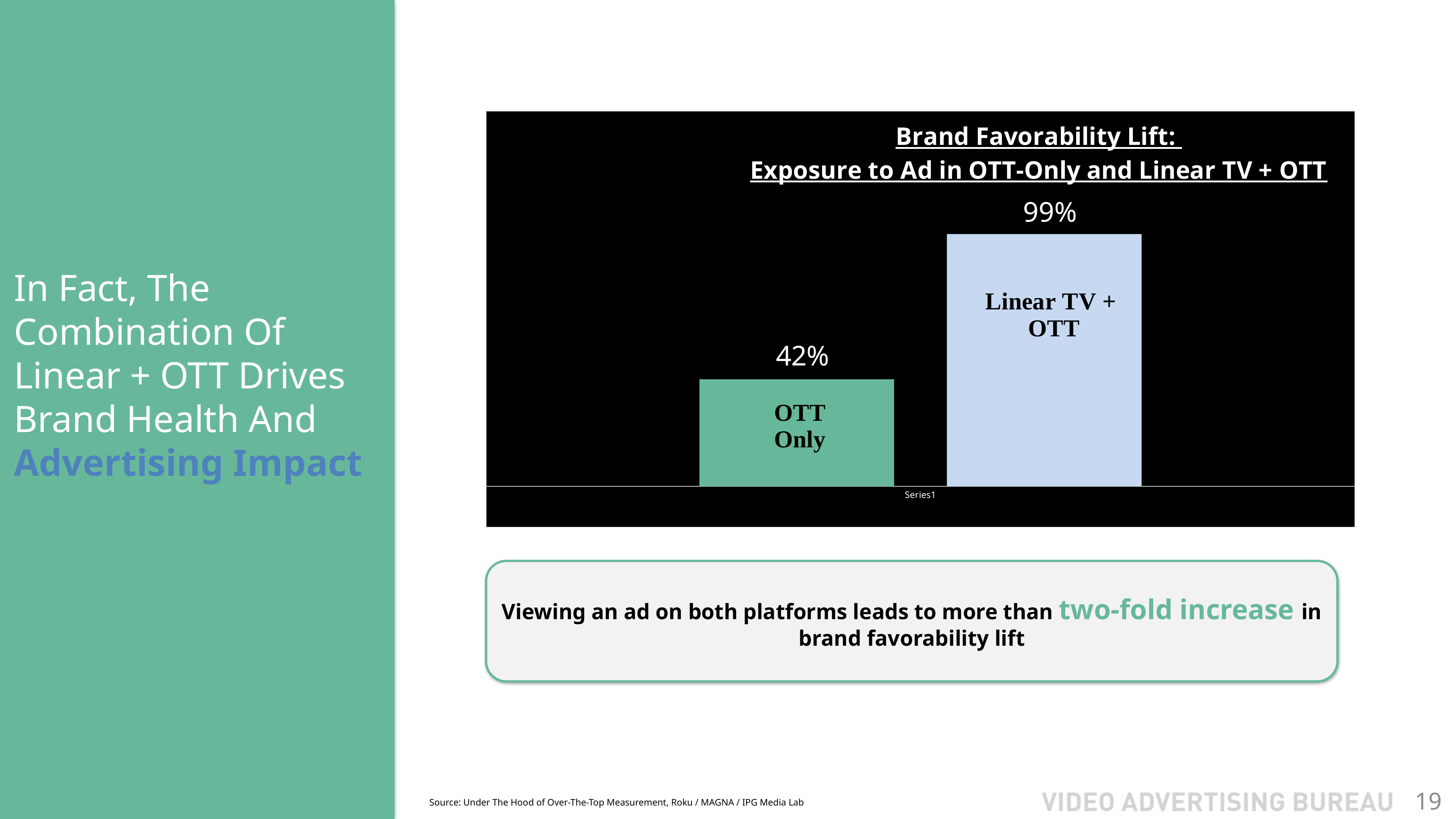
Is the brand favorability lift larger for OTT Only or for Linear TV + OTT? Linear TV + OTT Which bar shows the higher brand favorability lift? Linear TV + OTT What is the title of the chart? Brand Favorability Lift: Exposure to Ad in OTT-Only and Linear TV + OTT How many bars are plotted in the chart? 2 Which bar shows the lower brand favorability lift? OTT Only What is the x-axis label shown beneath the bars? Series1 What is the difference in brand favorability lift between Linear TV + OTT and OTT Only? 57% What colour is the OTT Only bar? Green What is the brand favorability lift for Linear TV + OTT? 99% What kind of chart is shown on the slide? Bar chart What is the brand favorability lift for OTT Only? 42%